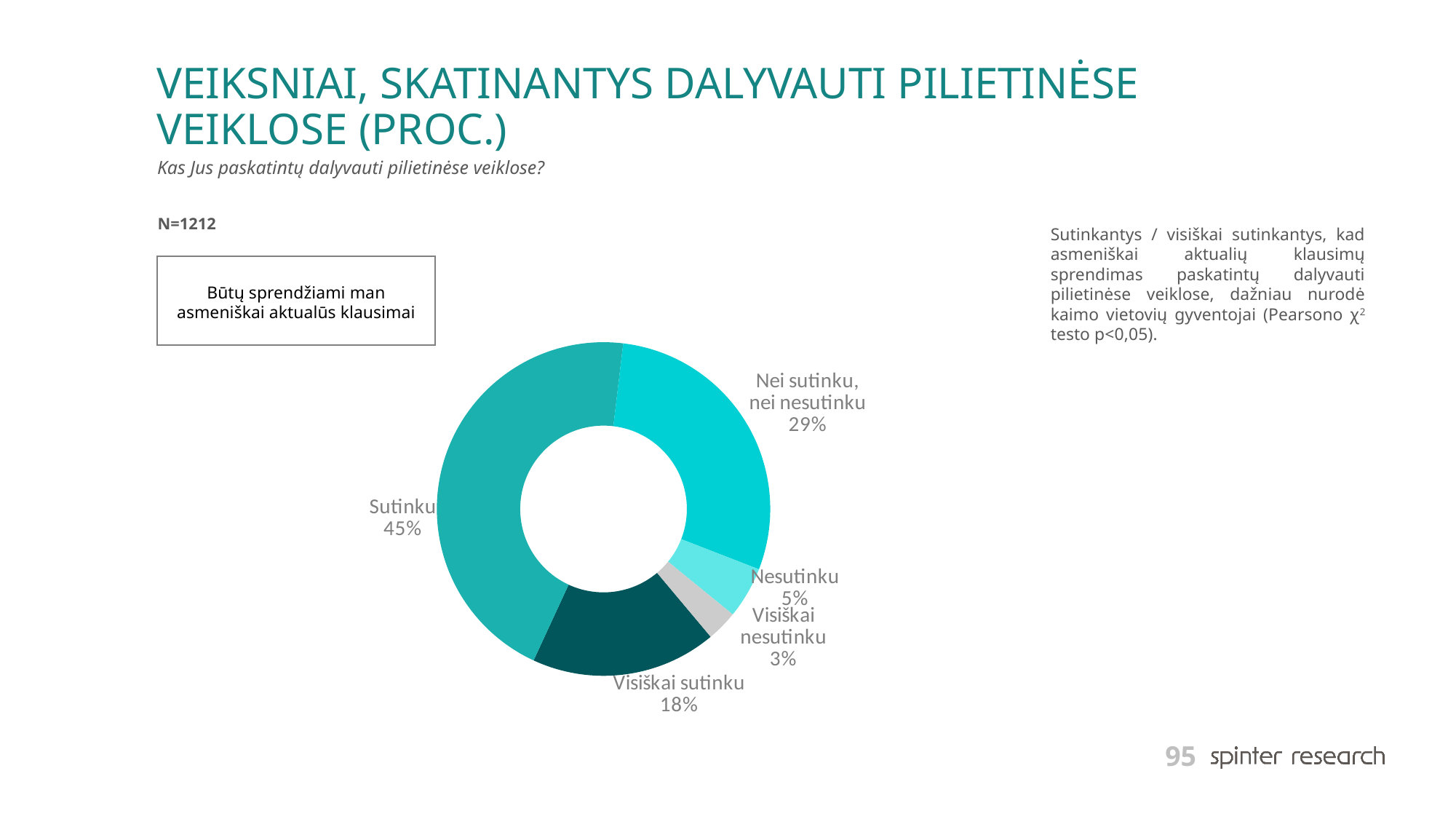
What is the sample size (N) stated on the slide? N=1212 What kind of chart is shown on the slide? Pie chart (doughnut) What percentage of respondents answered "Nei sutinku, nei nesutinku"? 29% What percentage of respondents answered "Visiškai sutinku"? 18% Which response category has the smallest share of the pie? Visiškai nesutinku How many response categories are shown in the chart? 5 What percentage of respondents answered "Visiškai nesutinku"? 3% What is the difference in percentage points between "Sutinku" and "Nei sutinku, nei nesutinku"? 16 Which is larger, the share for "Visiškai sutinku" or the share for "Nesutinku"? Visiškai sutinku What percentage of respondents answered "Nesutinku"? 5% Which response category has the largest share of the pie? Sutinku What percentage of respondents answered "Sutinku"? 45%